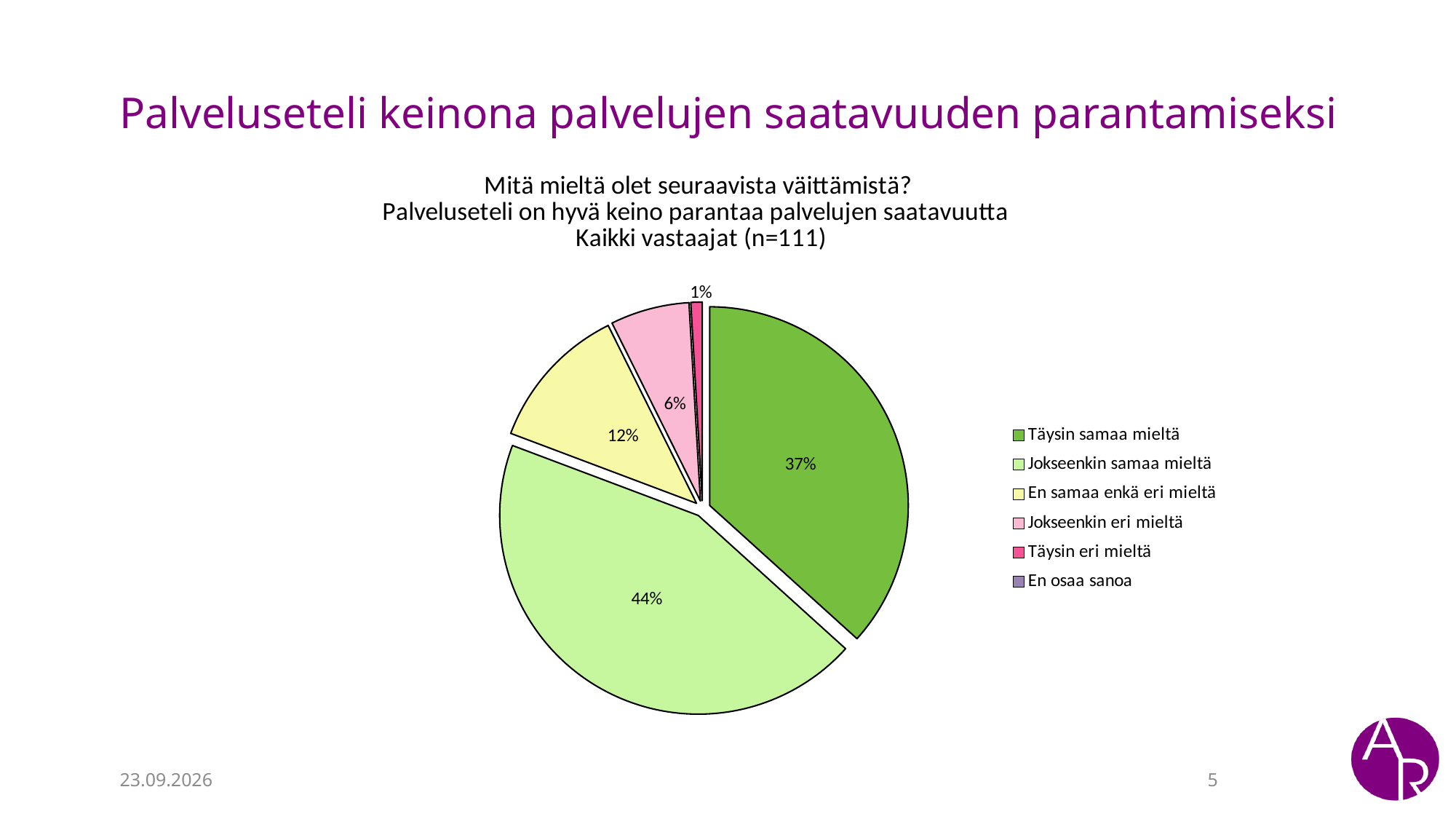
What share of respondents answered "Jokseenkin samaa mieltä"? 44% Which response category has the largest slice of the pie? Jokseenkin samaa mieltä What share of respondents answered "Täysin samaa mieltä"? 37% How many respondents does the chart subtitle say were included (n)? 111 How many entries does the legend list? 6 What kind of chart is shown on the slide? pie chart What share of respondents answered "En samaa enkä eri mieltä"? 12% What share of respondents answered "Jokseenkin eri mieltä"? 6% What is the difference in percentage points between "Jokseenkin samaa mieltä" and "Täysin samaa mieltä"? 7 percentage points Which is larger: the share for "En samaa enkä eri mieltä" or the share for "Jokseenkin eri mieltä"? En samaa enkä eri mieltä What share of respondents answered "Täysin eri mieltä"? 1% Which response category with a visible slice has the smallest share? Täysin eri mieltä